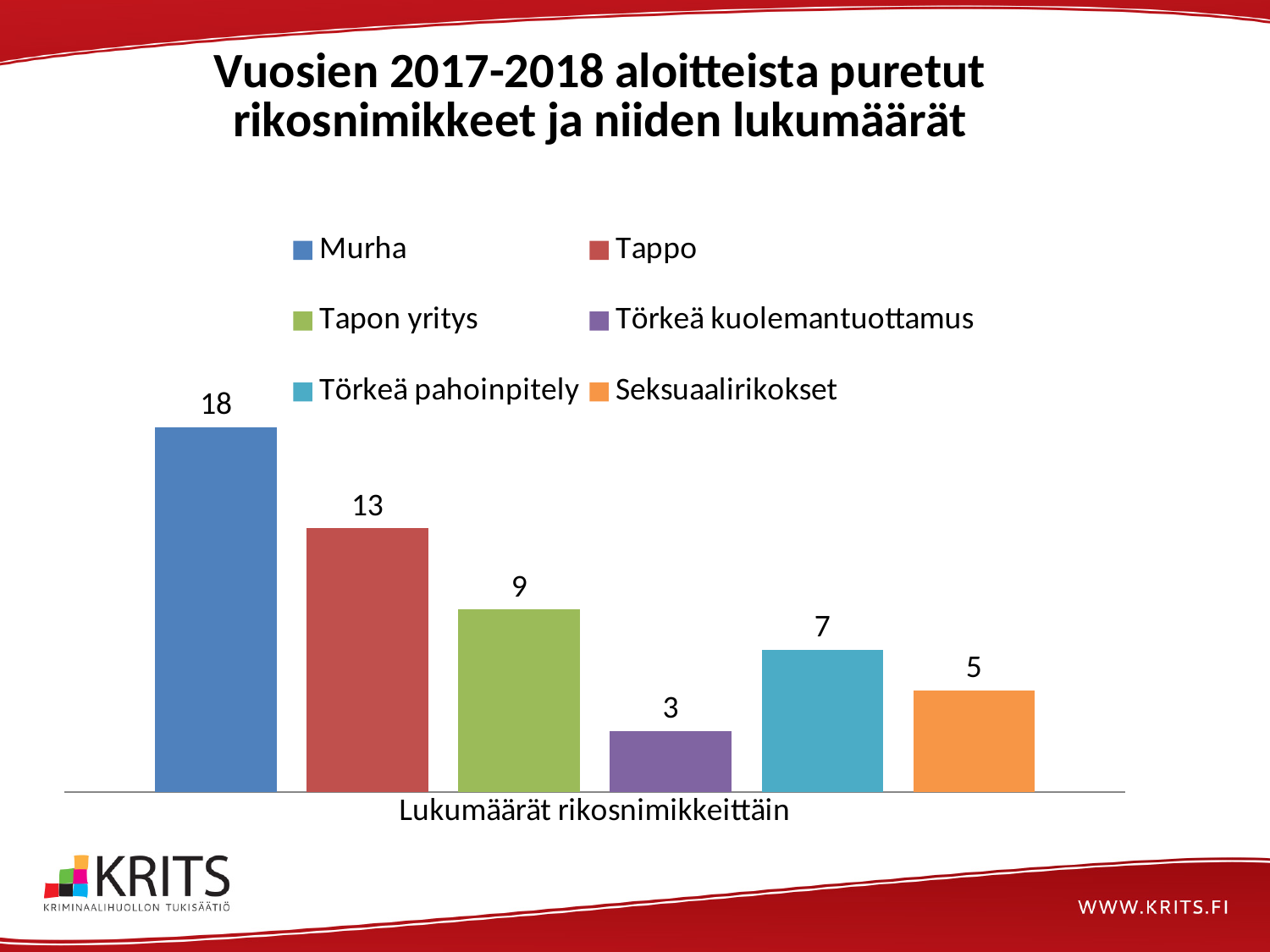
Which series has the highest value? Murha Which is larger, the value for Törkeä pahoinpitely or the value for Seksuaalirikokset? Törkeä pahoinpitely What is the label shown below the bars on the x axis? Lukumäärät rikosnimikkeittäin What is the value for Tappo? 13 What is the value for Tapon yritys? 9 How many series does the legend list? 6 What is the value for Törkeä kuolemantuottamus? 3 What is the difference between the values for Murha and Tappo? 5 What kind of chart is shown on the slide? Bar chart Which series has the lowest value? Törkeä kuolemantuottamus What is the value for Murha? 18 What is the value for Seksuaalirikokset? 5